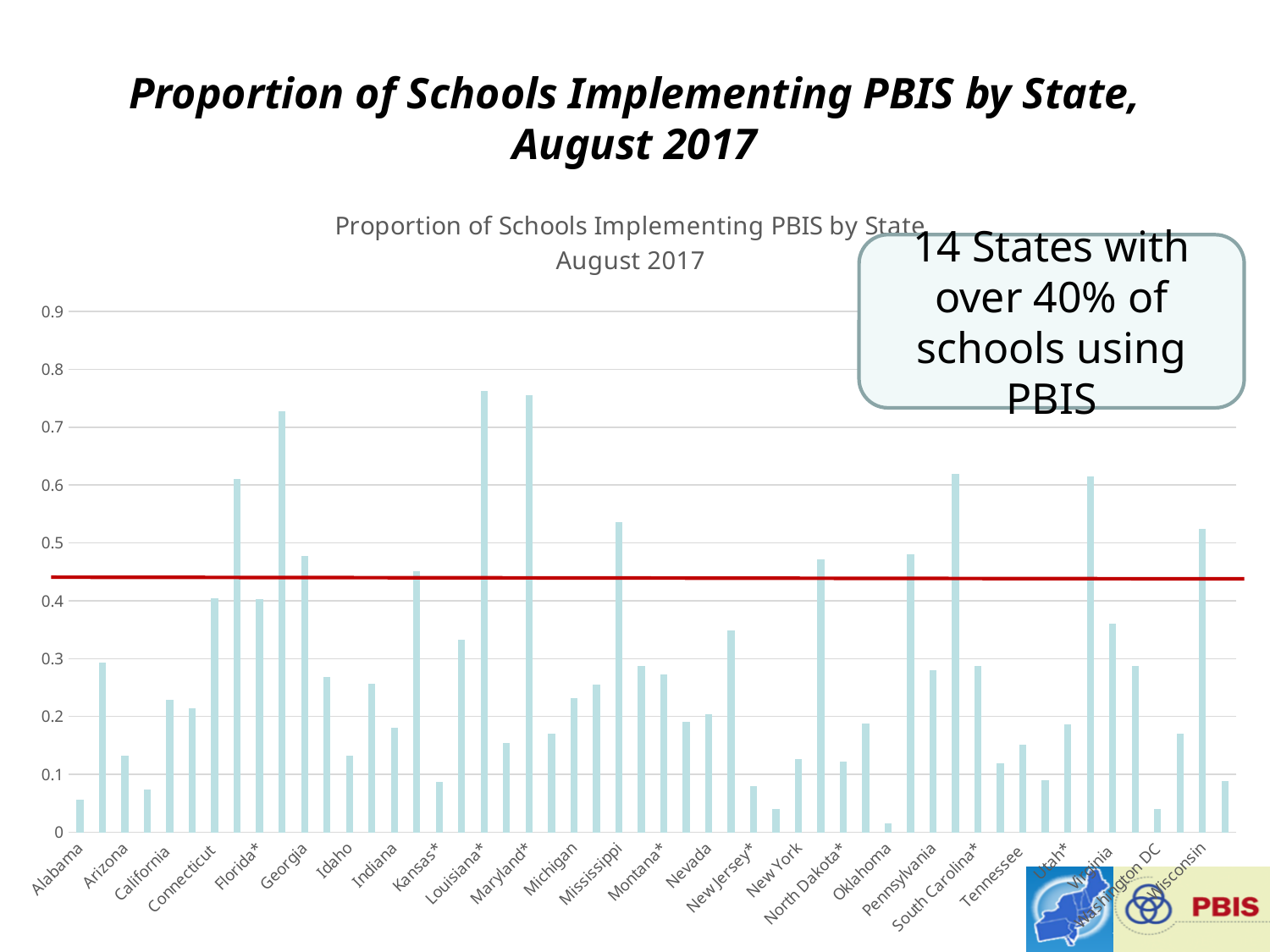
Is the value for Alabama greater or less than 0.1? less How many state names are printed as labels along the horizontal axis of the chart? 26 Is the value for Alabama greater or less than 0.2? less According to the callout on the slide, how many states have over 40% of schools using PBIS? 14 Which state is labeled first (leftmost) on the horizontal axis? Alabama What is the highest value shown on the vertical axis of the chart? 0.9 Is the value for Alabama greater or less than the value for Arizona? less Is the tallest bar in the chart greater or less than 0.7? greater What kind of chart is shown on the slide? bar chart